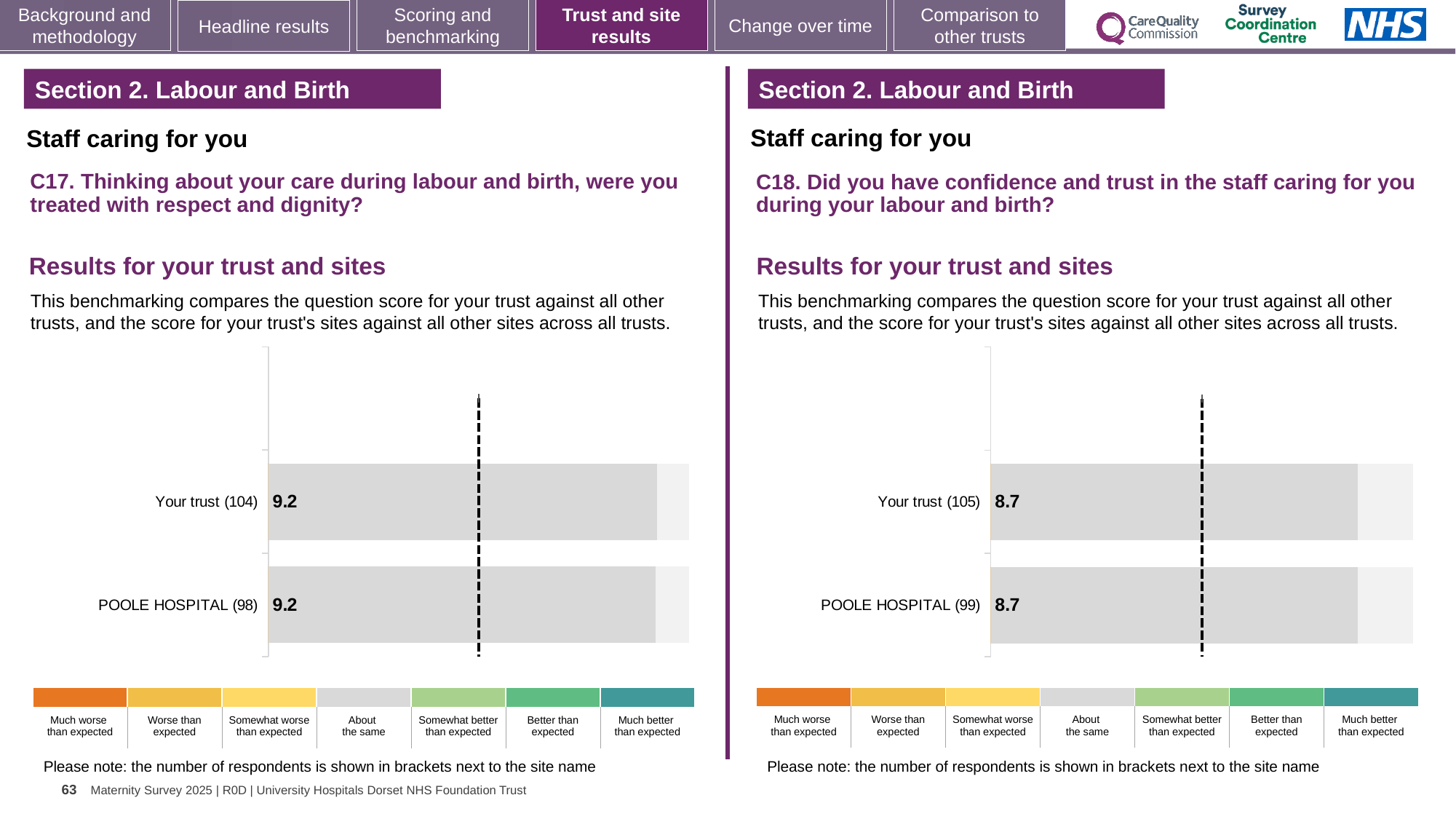
In the C17 chart on the left, what is the score for POOLE HOSPITAL? 9.2 In the C18 chart on the right, what is the score for POOLE HOSPITAL? 8.7 Is the score for Your trust in the C18 chart on the right greater or less than the score for Your trust in the C17 chart on the left? less In the C17 chart on the left, what is the difference between the score for Your trust and the score for POOLE HOSPITAL? 0 How many bars are plotted in the C17 chart on the left? 2 In the C17 chart on the left, how many respondents are shown in brackets for Your trust? 104 How many bars are plotted in the C18 chart on the right? 2 What kind of chart is used for the C17 results on the left? Bar chart In the C18 chart on the right, how many respondents are shown in brackets for POOLE HOSPITAL? 99 In the C17 chart on the left, what is the score for Your trust? 9.2 In the C18 chart on the right, what is the difference between the score for Your trust and the score for POOLE HOSPITAL? 0 In the C18 chart on the right, what is the score for Your trust? 8.7